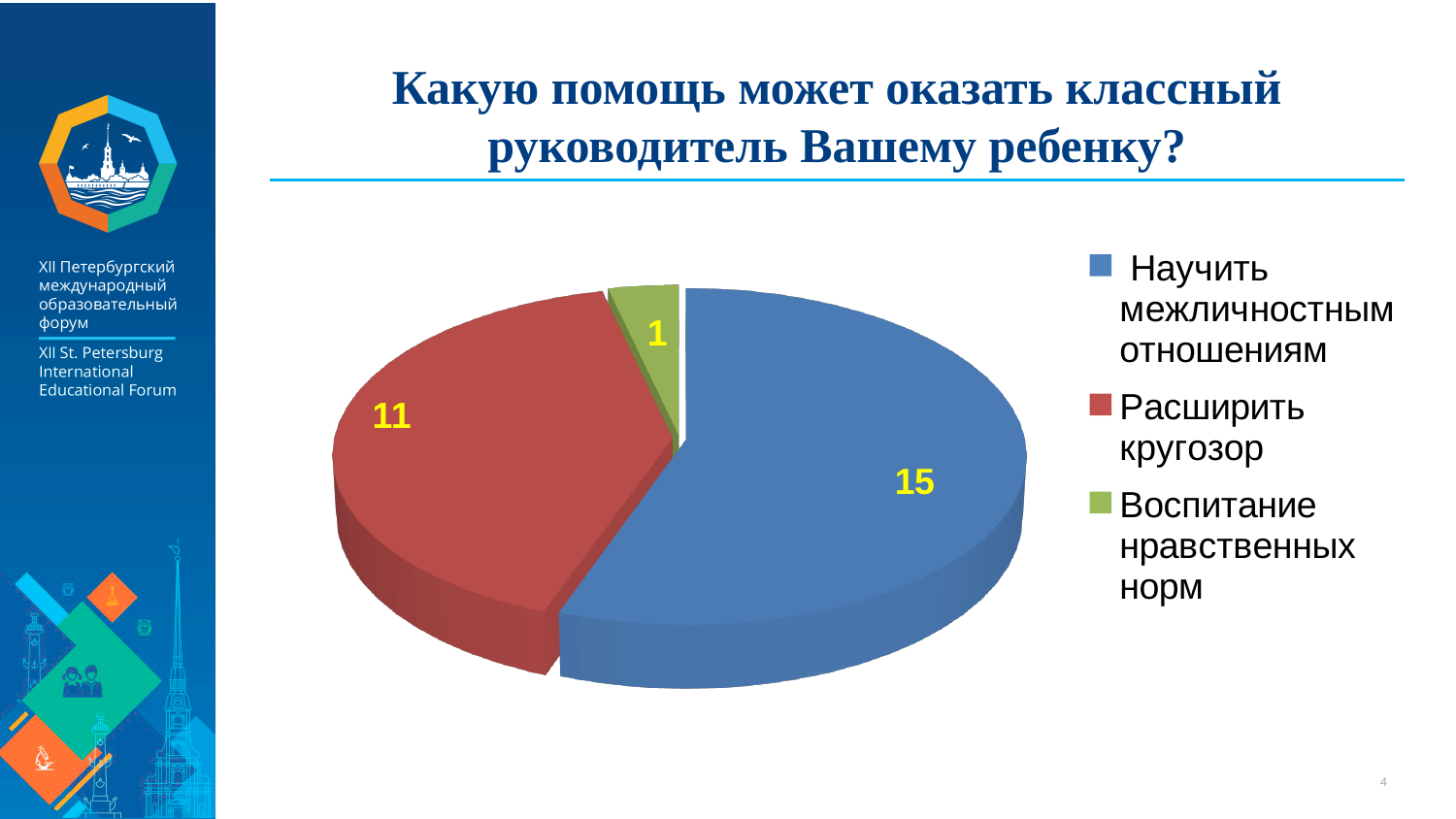
What is the value for "Расширить кругозор"? 11 What is the value for "Воспитание нравственных норм"? 1 Which is larger: the value for "Расширить кругозор" or the value for "Воспитание нравственных норм"? Расширить кругозор Which category has the smallest slice of the pie? Воспитание нравственных норм What is the value for "Научить межличностным отношениям"? 15 What is the difference between the values for "Расширить кругозор" and "Воспитание нравственных норм"? 10 What kind of chart is shown on the slide? Pie chart What is the total of all slices in the pie chart? 27 What colour is the slice for "Расширить кругозор"? Red What is the difference between the values for "Научить межличностным отношениям" and "Расширить кругозор"? 4 Which category has the largest slice of the pie? Научить межличностным отношениям How many categories does the pie chart have? 3